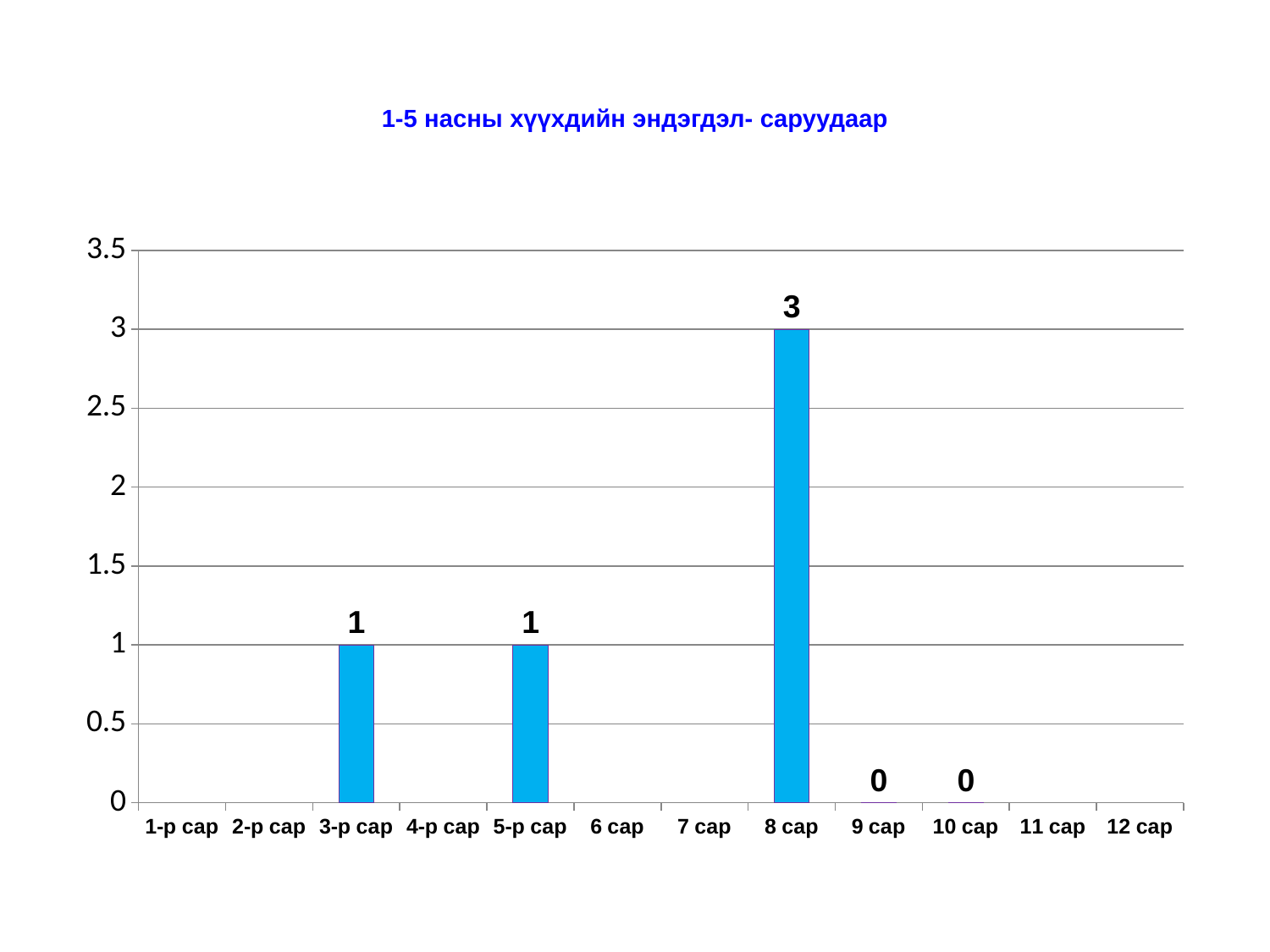
What is the difference between the values for 8 сар and 3-р сар? 2 What is the value for 8 сар? 3 What is the value for 5-р сар? 1 Is the value for 8 сар greater or less than 2? greater What kind of chart is shown on the slide? bar chart Which is larger, the value for 8 сар or the value for 5-р сар? 8 сар What is the value labelled for 10 сар? 0 What is the value labelled for 9 сар? 0 How many month categories are shown on the x axis? 12 What is the value for 3-р сар? 1 What is the title of the chart? 1-5 насны хүүхдийн эндэгдэл- саруудаар Which month has the highest value? 8 сар